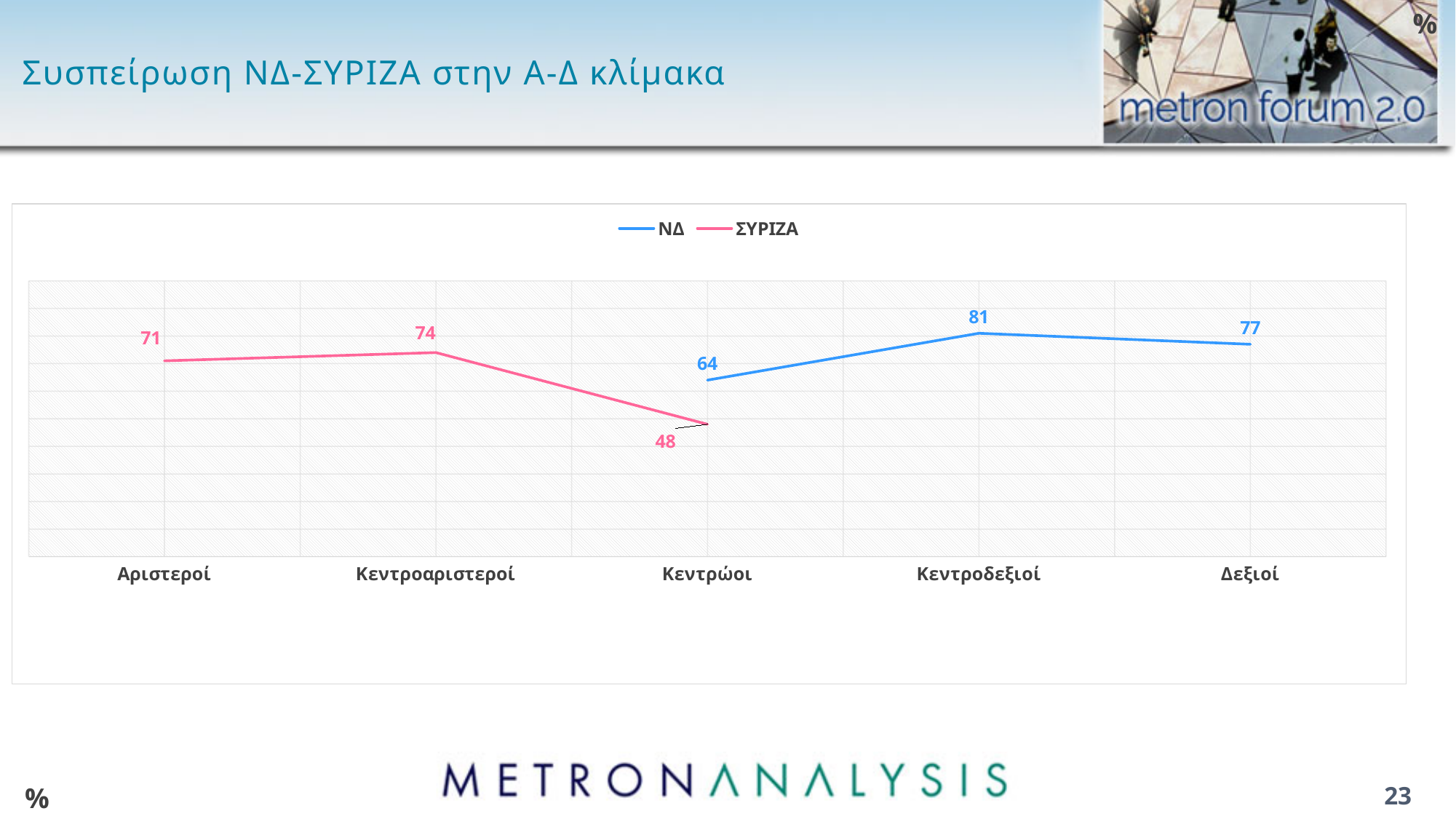
What is the ΝΔ value for Κεντροδεξιοί? 81 What is the ΝΔ value for Κεντρώοι? 64 Which category has the highest ΝΔ value? Κεντροδεξιοί What is the ΣΥΡΙΖΑ value for Αριστεροί? 71 What is the ΝΔ value for Δεξιοί? 77 Which category has the lowest ΣΥΡΙΖΑ value? Κεντρώοι What is the difference between the ΝΔ value and the ΣΥΡΙΖΑ value for Κεντρώοι? 16 What is the ΣΥΡΙΖΑ value for Κεντρώοι? 48 What is the ΣΥΡΙΖΑ value for Κεντροαριστεροί? 74 What kind of chart is shown on the slide? Line chart How many series does the legend list? 2 Which is larger: the ΝΔ value for Κεντροδεξιοί or the ΝΔ value for Δεξιοί? Κεντροδεξιοί